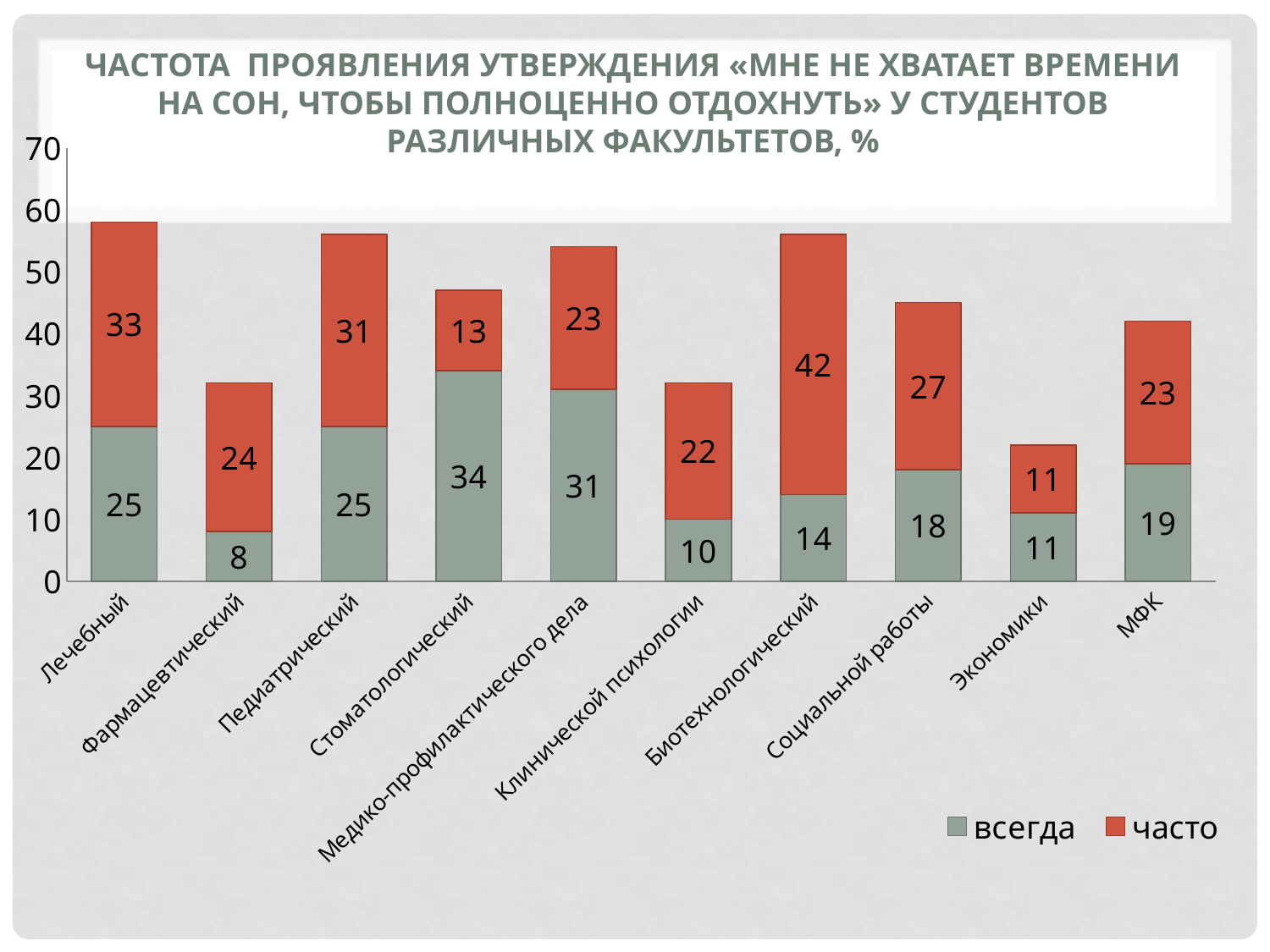
Which faculty has the highest value for «часто»? Биотехнологический Which series is shown in red in the legend? часто What is the value of «всегда» for Стоматологический? 34 Which is larger for Социальной работы: the «всегда» value or the «часто» value? часто What is the difference between the «часто» and «всегда» values for Клинической психологии? 12 What is the value of «часто» for Биотехнологический? 42 What is the total of the stacked bar for Лечебный? 58 Which faculty has the lowest value for «всегда»? Фармацевтический How many faculties (categories) are shown on the x axis? 10 Which faculty has the highest value for «всегда»? Стоматологический How many series does the legend list? 2 What type of chart is shown on the slide? stacked bar chart